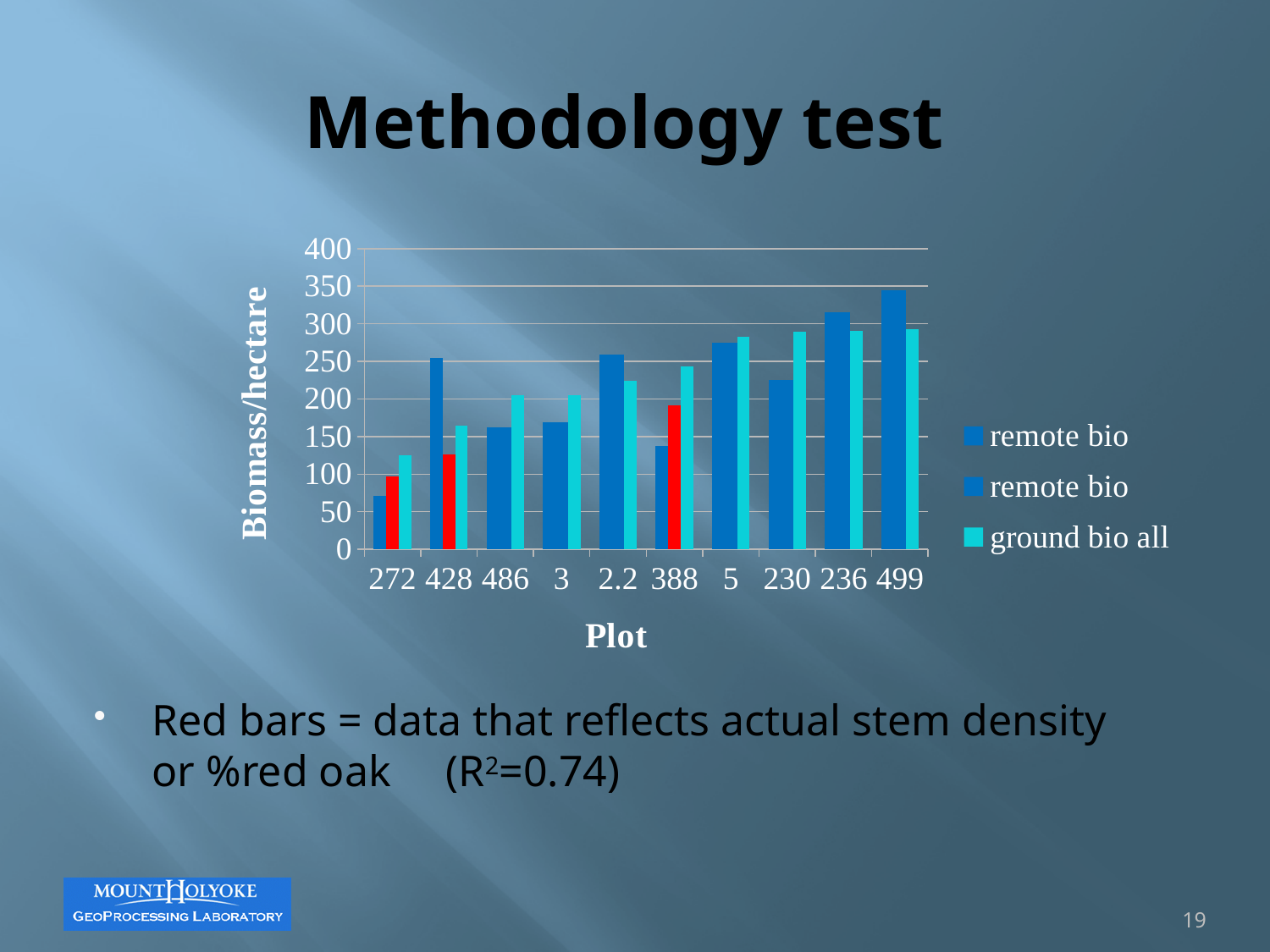
Which plot has the highest remote bio (dark blue) bar? 499 How many series does the legend list? 3 What is the title of the y axis? Biomass/hectare How many plot categories are shown on the x axis? 10 Is the remote bio (dark blue) value for plot 499 greater or less than 300? greater What is the title of the x axis? Plot Which plot has the lowest remote bio (dark blue) bar? 272 For plot 428, which is larger: the remote bio (dark blue) bar or the ground bio all bar? remote bio (dark blue) What kind of chart is shown on the slide? bar chart For plot 388, which is larger: the remote bio (dark blue) bar or the ground bio all bar? ground bio all Is the ground bio all value for plot 388 greater or less than 200? greater Is the remote bio (dark blue) value for plot 272 greater or less than 100? less